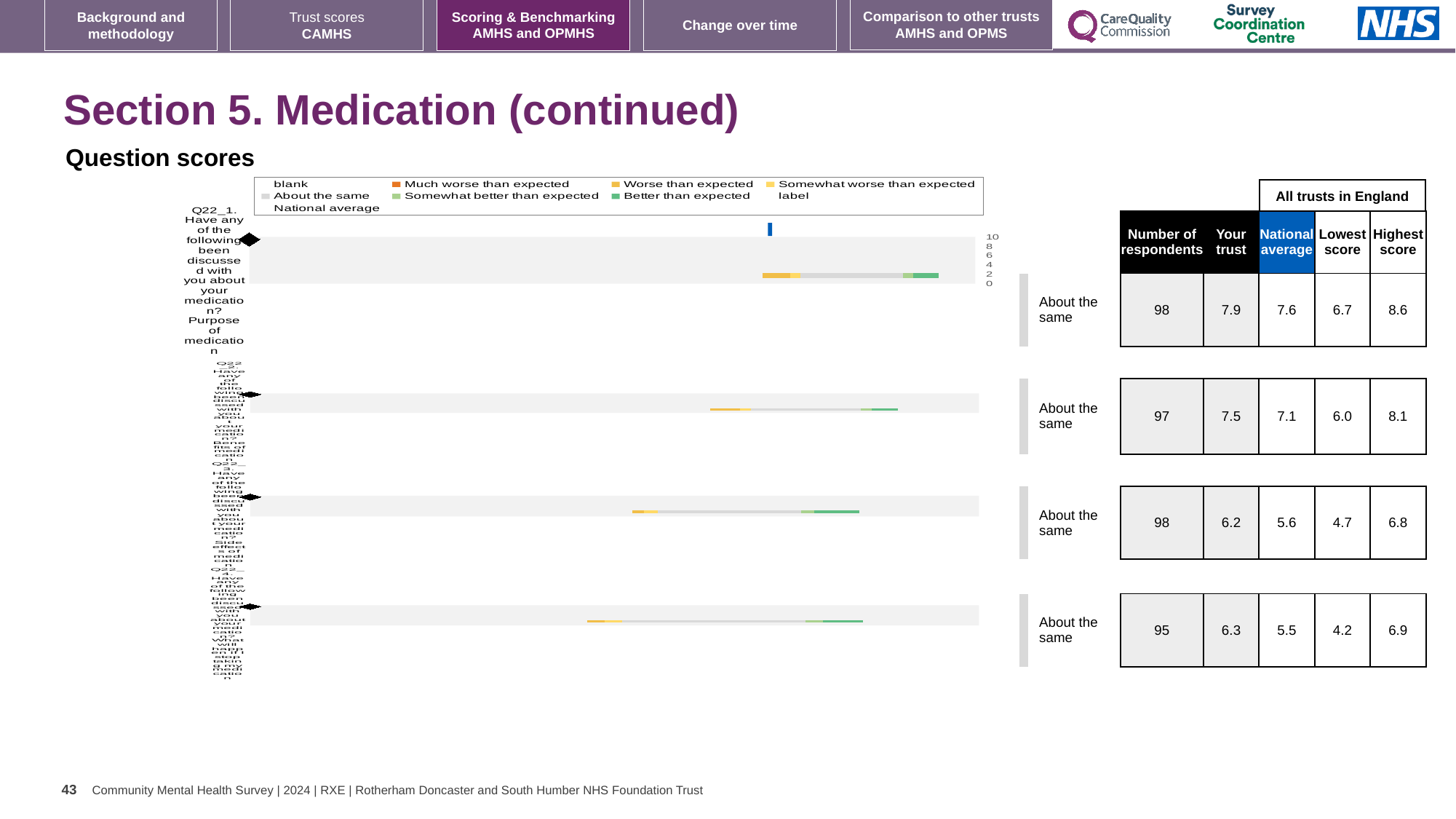
In the table beside the chart, what is the difference between 'Your trust' and the national average for the fourth row (Q22_4)? 0.8 In the table beside the chart, what is the national average for the third row (Q22_3, side effects of medication)? 5.6 Which legend entry in the 'Question scores' chart is shown in dark orange? Much worse than expected What kind of chart is shown under the heading 'Question scores'? bar chart In the table beside the chart, what is the 'Your trust' score for the first row (Q22_1, purpose of medication)? 7.9 In the table beside the chart, which is larger for the second row (Q22_2): 'Your trust' or the national average? Your trust How many entries does the legend of the 'Question scores' chart list? 9 How many question categories (bars) are plotted in the 'Question scores' chart? 4 In the table beside the chart, what is the lowest score among all trusts in England for the fourth row (Q22_4)? 4.2 In the table beside the chart, which row has the highest 'Number of respondents'? Q22_1 and Q22_3 (98) What is the highest tick value shown on the chart's value axis? 10 What is the heading printed above the chart? Question scores